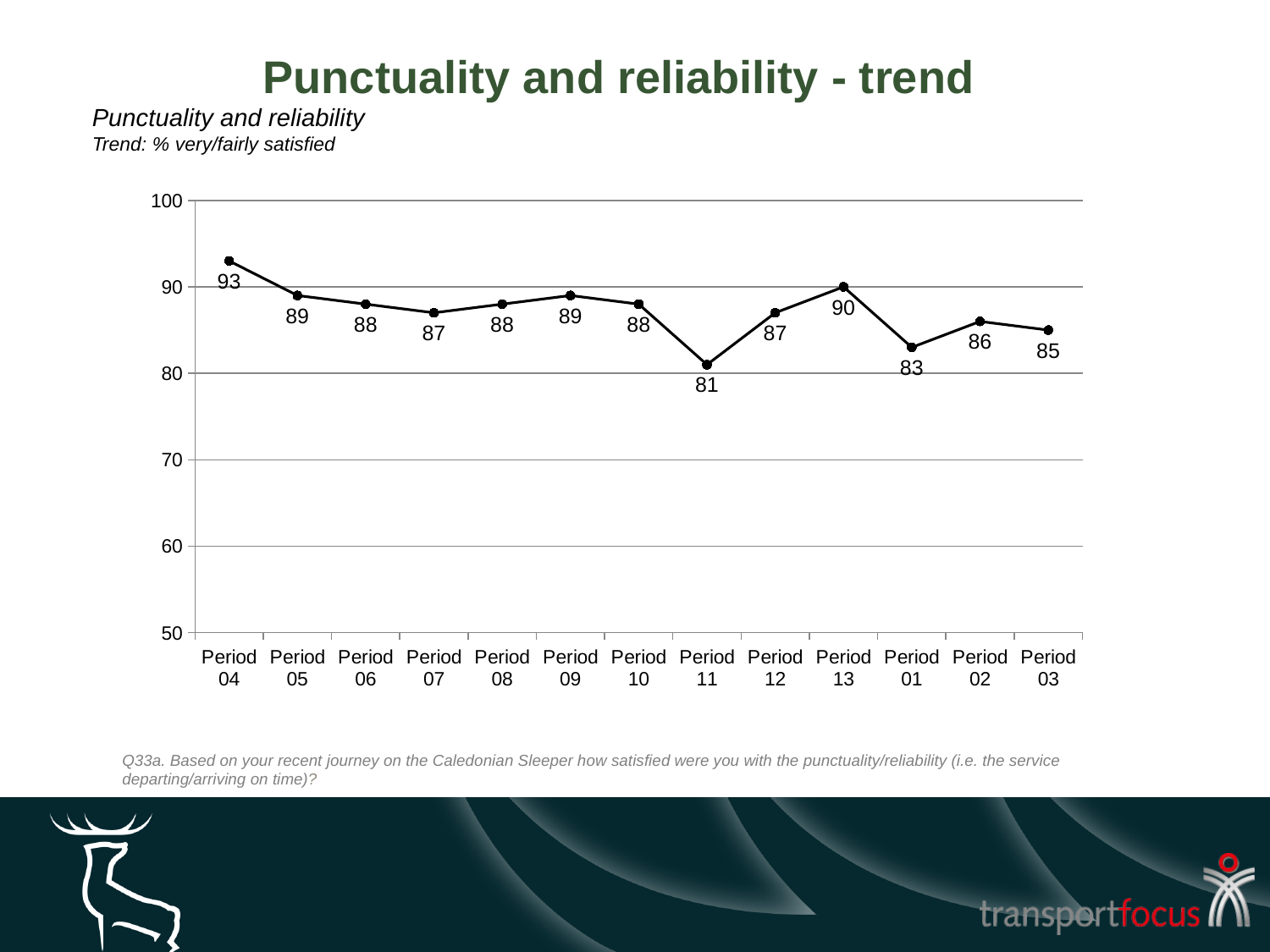
What is the subtitle shown below the chart title 'Punctuality and reliability'? Trend: % very/fairly satisfied Which period has the highest value? Period 04 What is the value for Period 03? 85 Do the values generally rise or fall from Period 04 to Period 03? fall Is the value for Period 11 greater or less than 90? less How many periods are plotted on the chart? 13 What is the value for Period 04? 93 Which is larger, the value for Period 13 or the value for Period 01? Period 13 Which period has the lowest value? Period 11 What is the value for Period 11? 81 What is the difference between the values for Period 04 and Period 11? 12 What kind of chart is shown on the slide? line chart